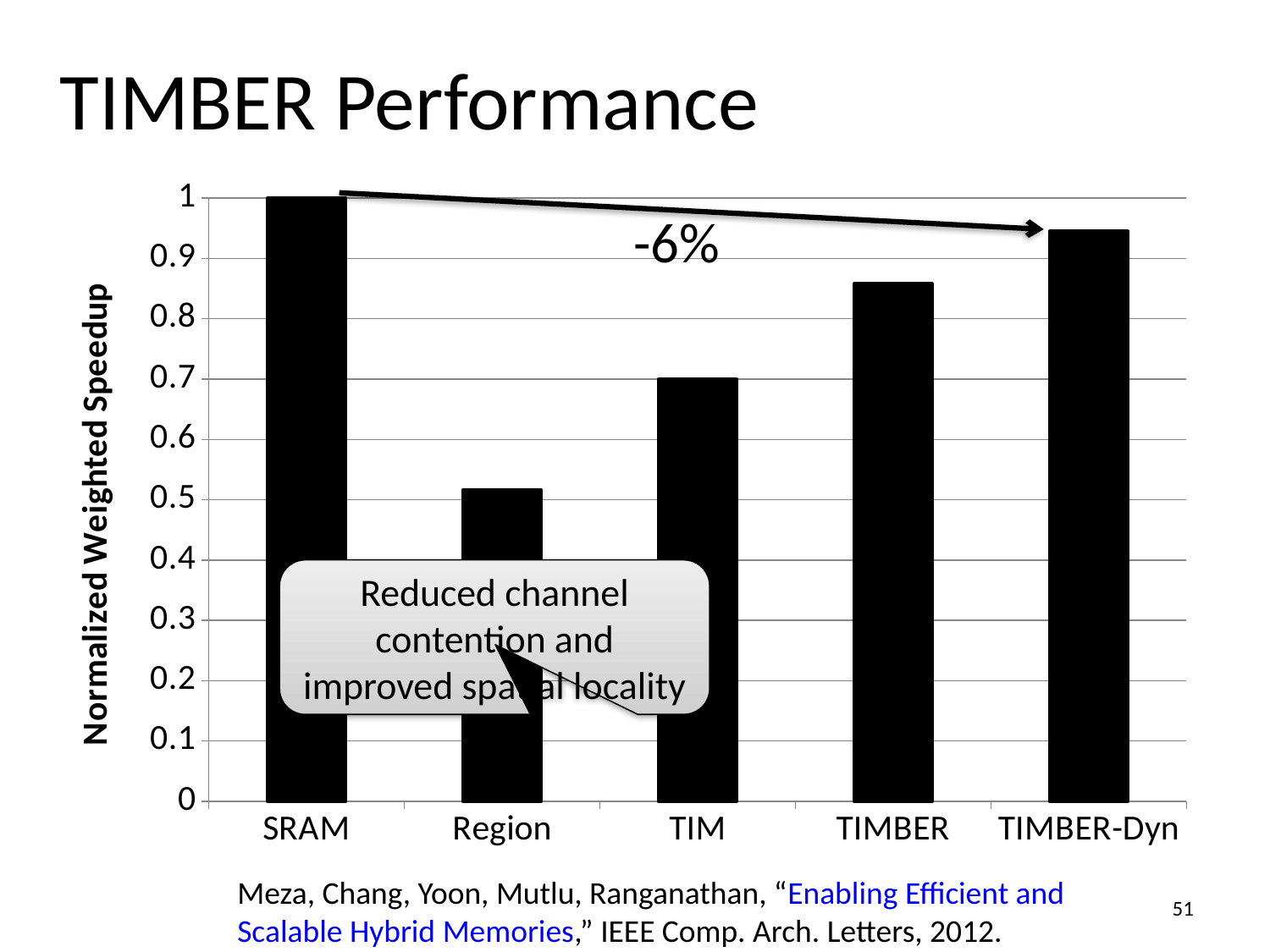
What is the normalized weighted speedup for SRAM? 1 How many categories are shown on the x axis of the chart? 5 What is the label of the y axis of the chart? Normalized Weighted Speedup Which has a higher normalized weighted speedup, TIMBER-Dyn or TIMBER? TIMBER-Dyn Which category has the highest normalized weighted speedup? SRAM Is the value for TIM greater or less than 0.6? greater Which category has the lowest normalized weighted speedup? Region What kind of chart is shown on the slide? bar chart Which has a higher normalized weighted speedup, TIMBER or TIM? TIMBER Is the value for Region greater or less than 0.6? less Is the value for TIMBER greater or less than 0.8? greater